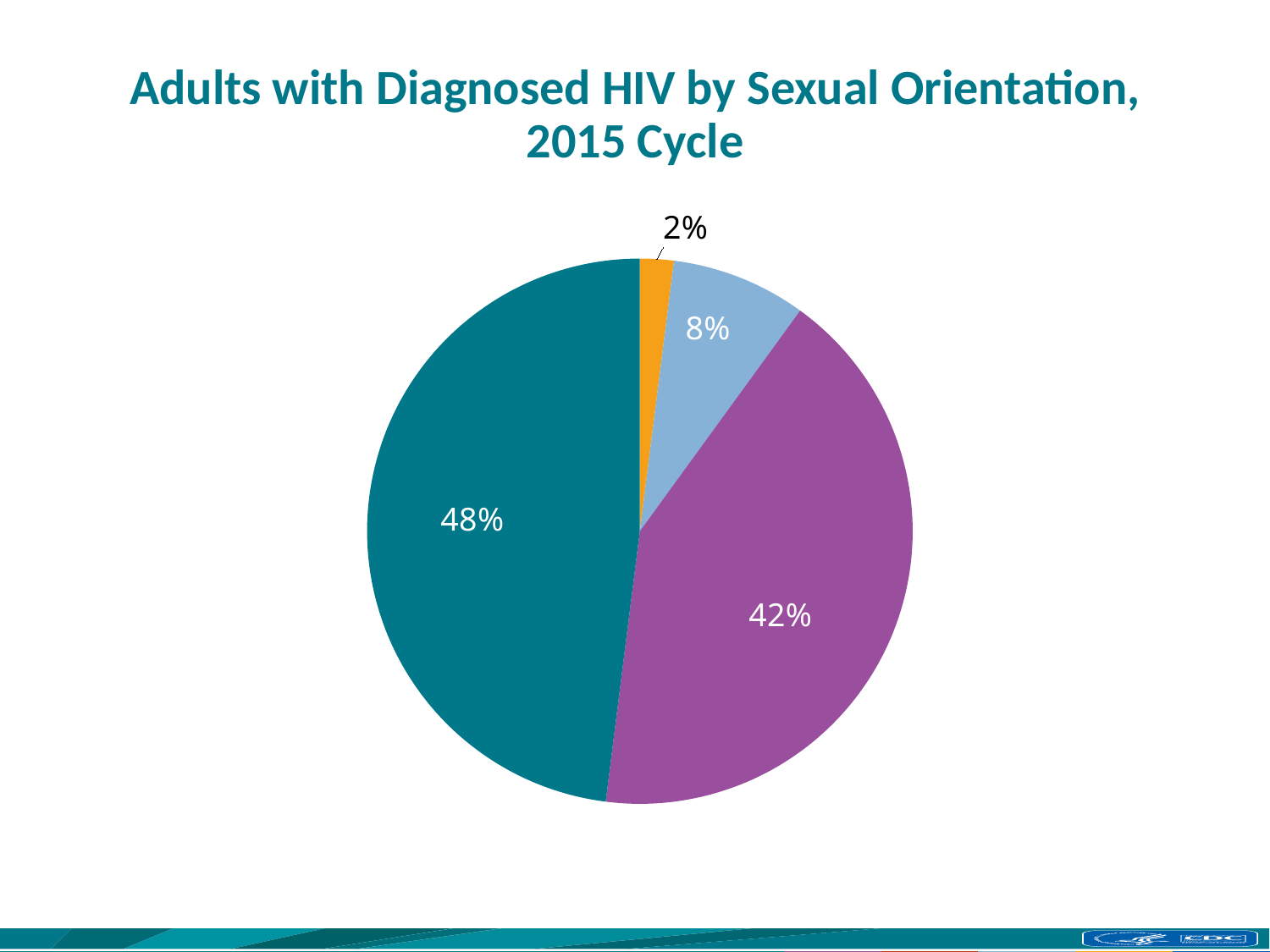
Which slice is larger, the one labelled 8% or the one labelled 2%? 8% What do the two largest slices (48% and 42%) add up to? 90% What percentage is shown on the teal slice of the pie chart? 48% What is the largest percentage shown on the pie chart? 48% How many slices does the pie chart have? 4 What kind of chart is shown on the slide? pie chart What percentage is shown on the purple slice of the pie chart? 42% What percentage is shown on the light blue slice of the pie chart? 8% What is the difference in percentage points between the largest slice (48%) and the second largest slice (42%)? 6 What percentage is shown on the orange slice of the pie chart? 2% What is the title of the chart? Adults with Diagnosed HIV by Sexual Orientation, 2015 Cycle What is the smallest percentage shown on the pie chart? 2%